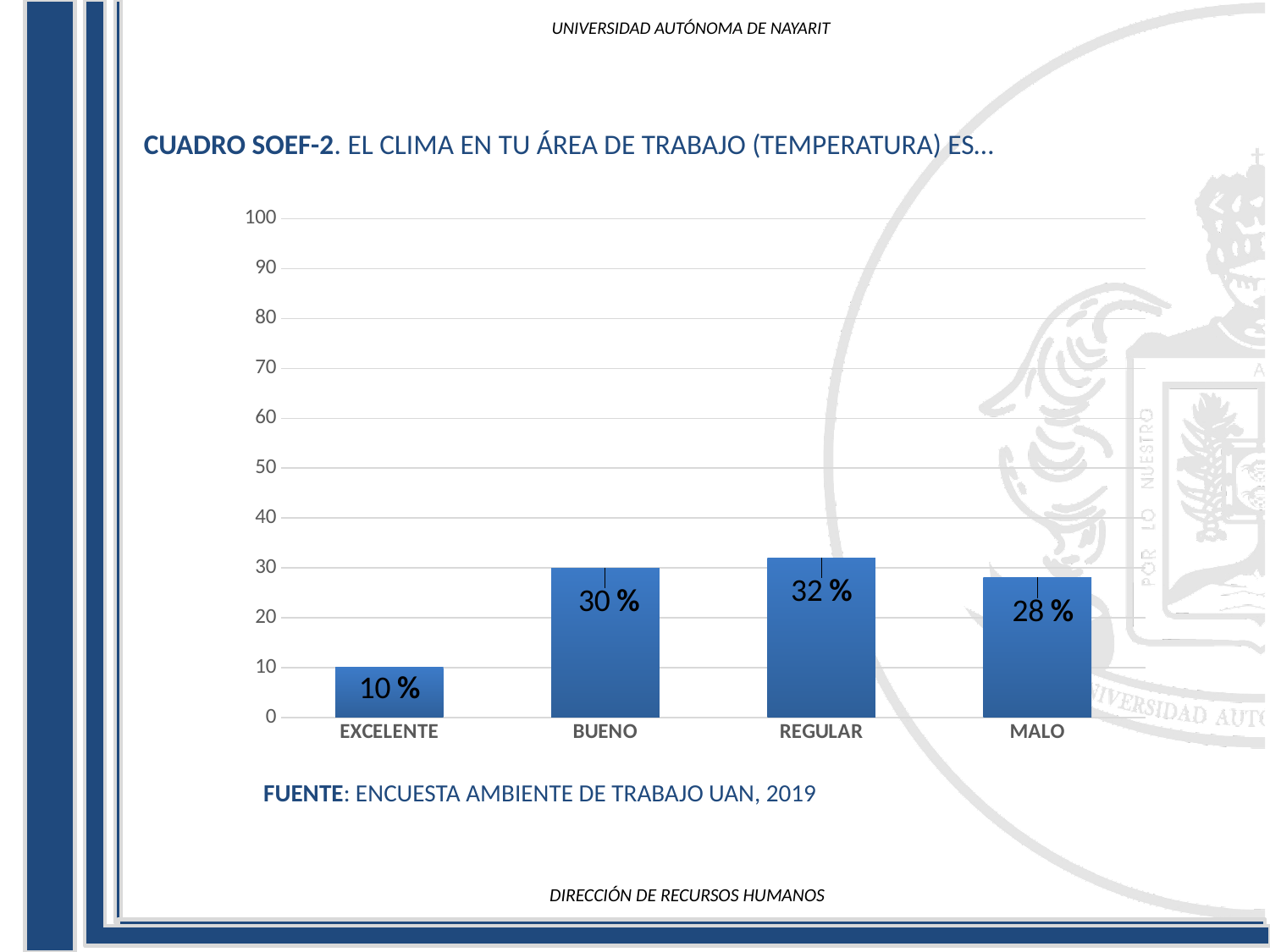
How many categories are shown on the x axis? 4 Which is larger, the value for BUENO or the value for MALO? BUENO What is the difference between the values for BUENO and MALO? 2 % Is the value for MALO greater or less than 20? greater What is the value for MALO? 28 % What kind of chart is shown on the slide? bar chart Which category has the lowest value? EXCELENTE Which category has the highest value? REGULAR What is the difference between the values for REGULAR and EXCELENTE? 22 % What is the value for REGULAR? 32 % What is the value for EXCELENTE? 10 % What is the value for BUENO? 30 %